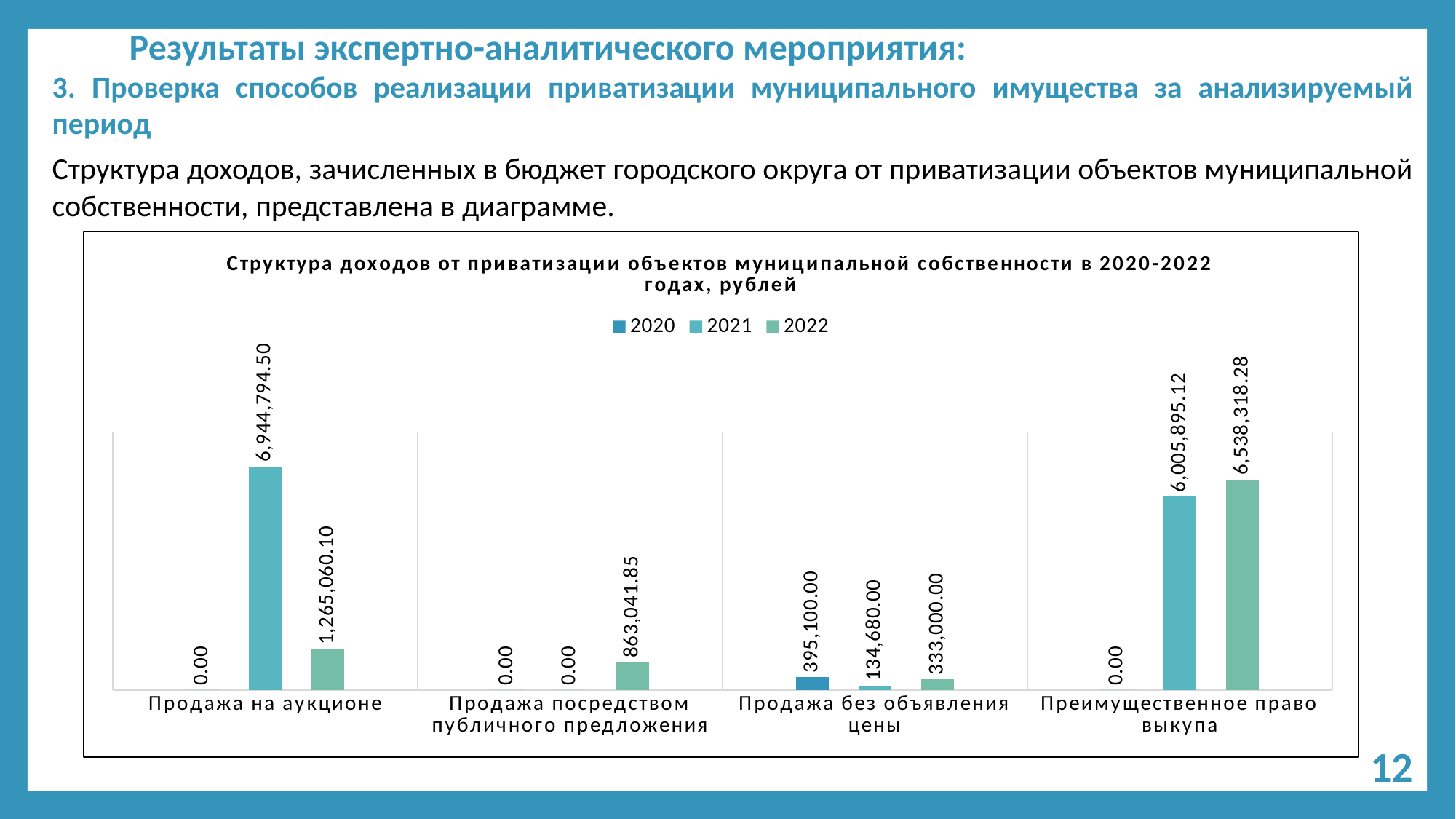
What type of chart is shown on the slide? Bar chart What is the title of the chart? Структура доходов от приватизации объектов муниципальной собственности в 2020-2022 годах, рублей What is the value for 2021 in the category 'Продажа на аукционе'? 6,944,794.50 In the category 'Продажа без объявления цены', which is larger: the 2020 value or the 2021 value? 2020 What is the value for 2022 in the category 'Продажа посредством публичного предложения'? 863,041.85 How many categories are shown on the x axis? 4 Which category has the lowest value for the 2022 series? Продажа без объявления цены What is the difference between the 2022 and 2021 values in the category 'Преимущественное право выкупа'? 532,423.16 What is the value for 2022 in the category 'Преимущественное право выкупа'? 6,538,318.28 Which category has the highest value for the 2021 series? Продажа на аукционе How many series does the legend list? 3 What is the value for 2020 in the category 'Продажа без объявления цены'? 395,100.00